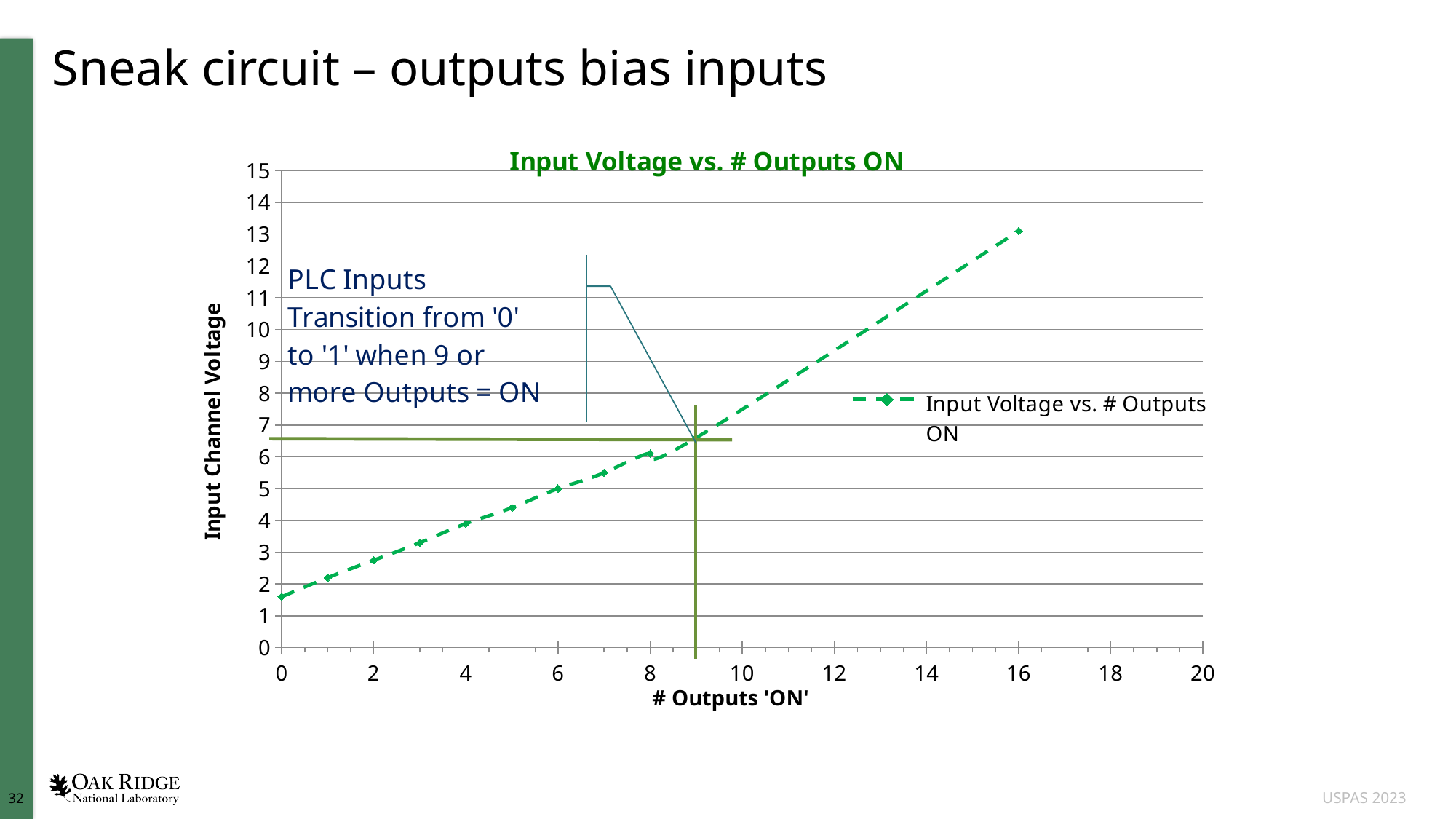
What is the title of the chart? Input Voltage vs. # Outputs ON Is the input channel voltage at 4 outputs ON greater or less than 5? less Is the input channel voltage at 16 outputs ON greater or less than 12? greater Does the input channel voltage rise or fall as the number of outputs ON increases? rises How many data points are plotted on the line? 11 How many series does the legend list? 1 Which has the larger input channel voltage: 8 outputs ON or 2 outputs ON? 8 outputs ON What is the label of the y axis? Input Channel Voltage At which number of outputs ON is the input channel voltage lowest? 0 What kind of chart is shown on the slide? line chart Is the input channel voltage at 0 outputs ON greater or less than 2? less At which number of outputs ON is the input channel voltage highest? 16